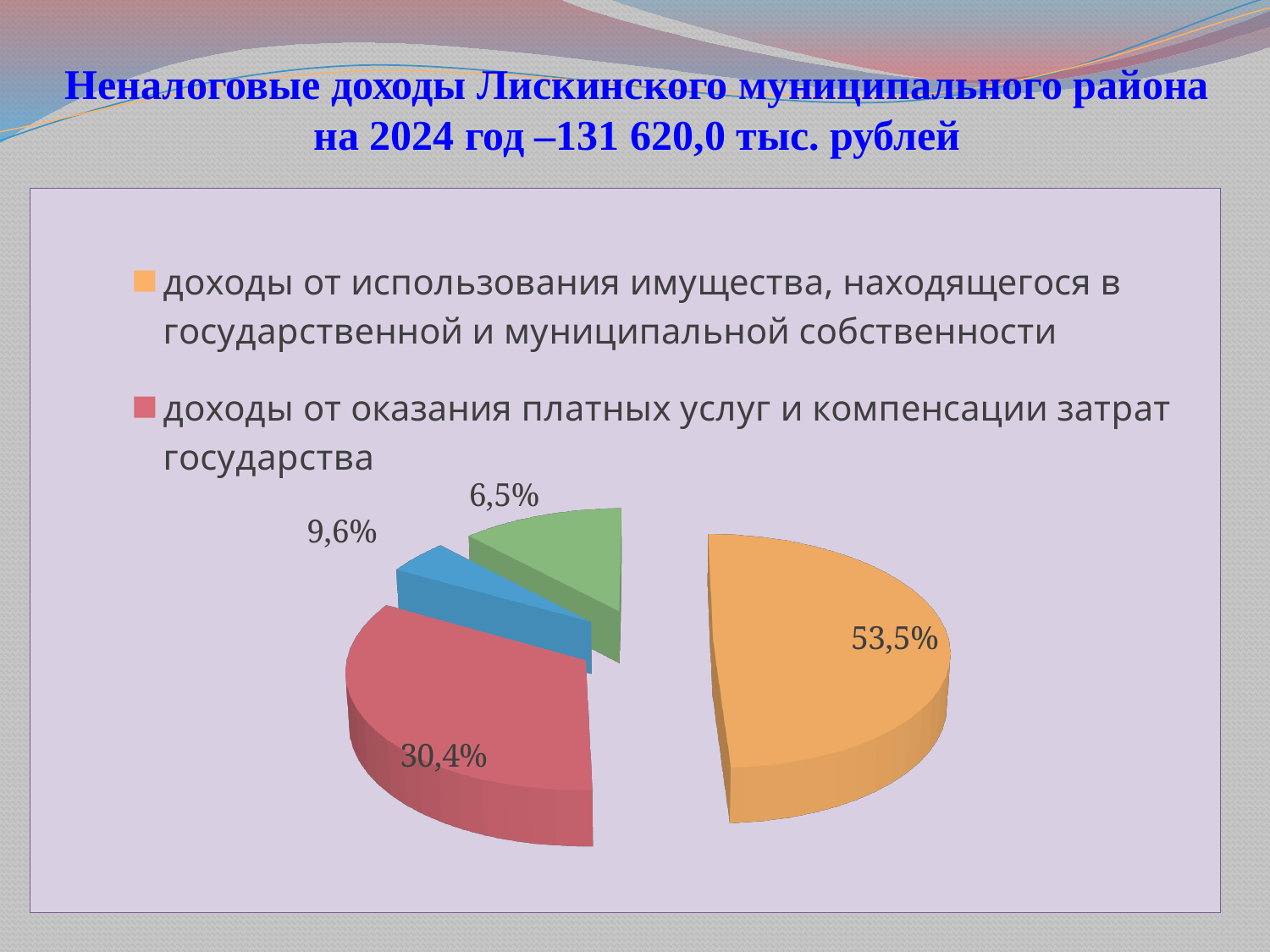
What percentage is shown on the blue slice of the pie? 9,6% What is the difference in percentage points between the orange slice (53,5%) and the red slice (30,4%)? 23,1 What share of the pie is labelled for the slice 'доходы от оказания платных услуг и компенсации затрат государства'? 30,4% What kind of chart is shown on the slide? pie chart What percentage is shown on the green slice of the pie? 6,5% Which is larger: the share for 'доходы от оказания платных услуг и компенсации затрат государства' or the blue slice? доходы от оказания платных услуг и компенсации затрат государства How many slices does the pie chart have? 4 What colour is the slice for 'доходы от использования имущества, находящегося в государственной и муниципальной собственности'? orange Which slice of the pie is the smallest? the green slice (6,5%) Which category has the largest share of the pie? доходы от использования имущества, находящегося в государственной и муниципальной собственности What total amount of non-tax revenue for 2024 is stated in the slide title? 131 620,0 тыс. рублей What share of the pie is labelled for the slice 'доходы от использования имущества, находящегося в государственной и муниципальной собственности'? 53,5%